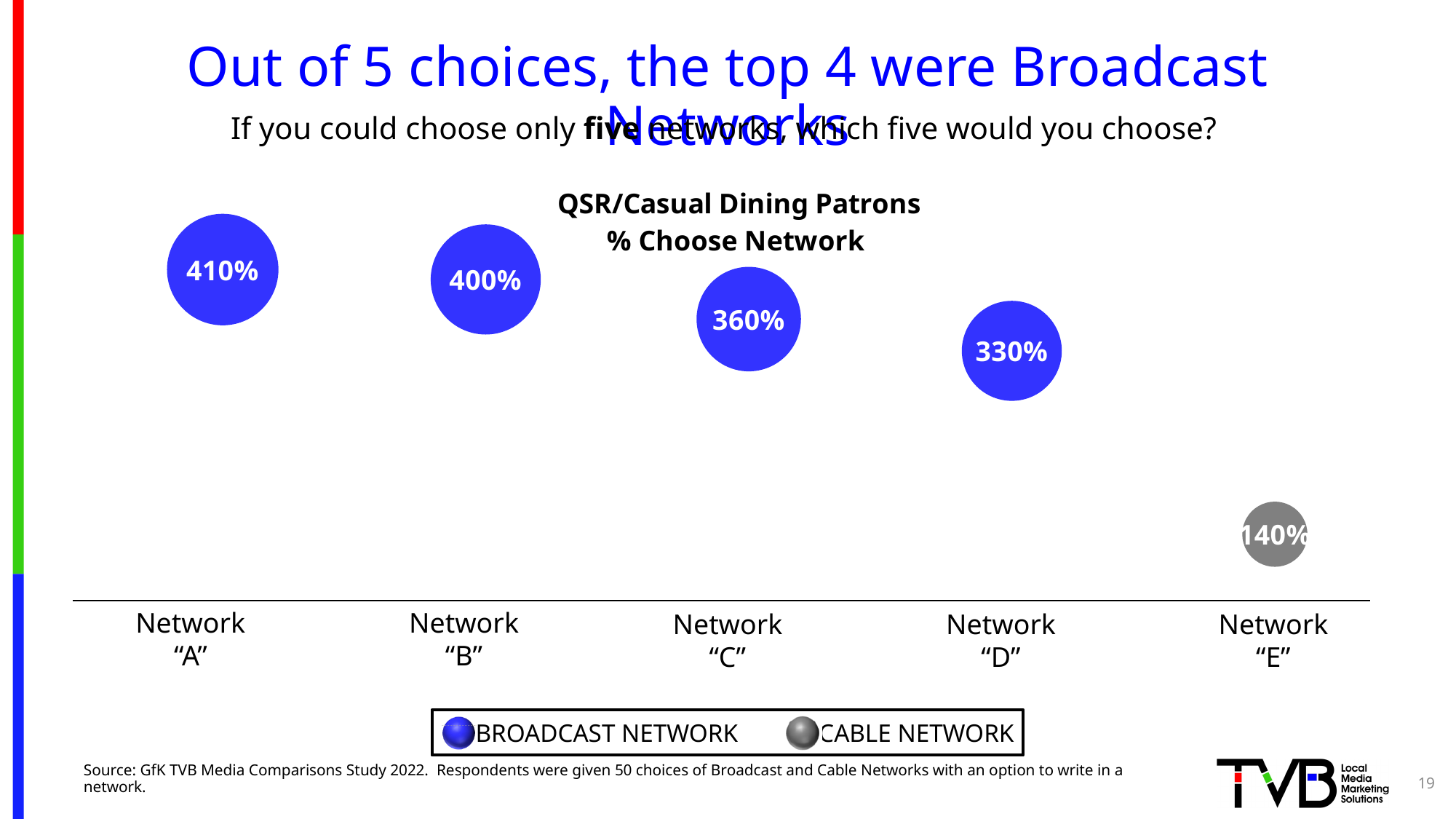
What is the difference between the values for Network "A" and Network "E"? 270% What is the value for Network "C"? 360% Which network has the lowest value? Network "E" Which network is shown as a Cable Network in the chart? Network "E" What is the value for Network "A"? 410% How many networks are shown in the chart? 5 How many entries does the legend list? 2 What is the value for Network "E"? 140% What is the difference between the values for Network "B" and Network "D"? 70% What kind of chart is shown on the slide? Bubble chart Which is larger, the value for Network "C" or the value for Network "D"? Network "C" Which network has the highest value? Network "A"